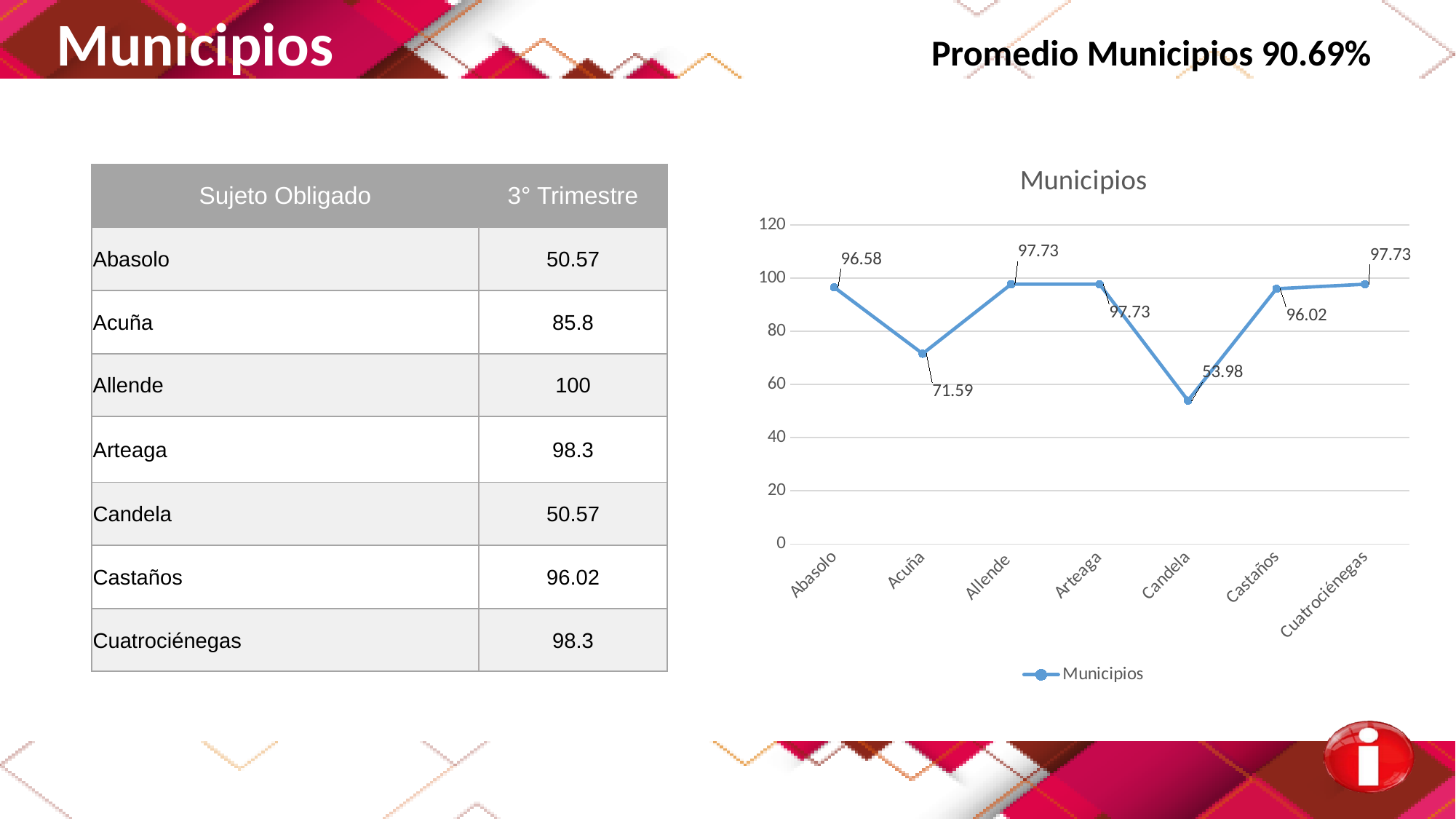
How many series does the legend of the Municipios chart list? 1 What is the value for Castaños in the Municipios chart? 96.02 Is the value for Candela in the Municipios chart greater or less than 60? less Which is larger in the Municipios chart, the value for Acuña or the value for Candela? Acuña How many categories are plotted in the Municipios chart? 7 What is the difference between the values for Allende and Candela in the Municipios chart? 43.75 What is the difference between the values for Abasolo and Acuña in the Municipios chart? 24.99 What is the value for Acuña in the Municipios chart? 71.59 Which category has the lowest value in the Municipios chart? Candela What is the value for Candela in the Municipios chart? 53.98 What is the value for Abasolo in the Municipios chart? 96.58 What kind of chart is the Municipios chart? line chart